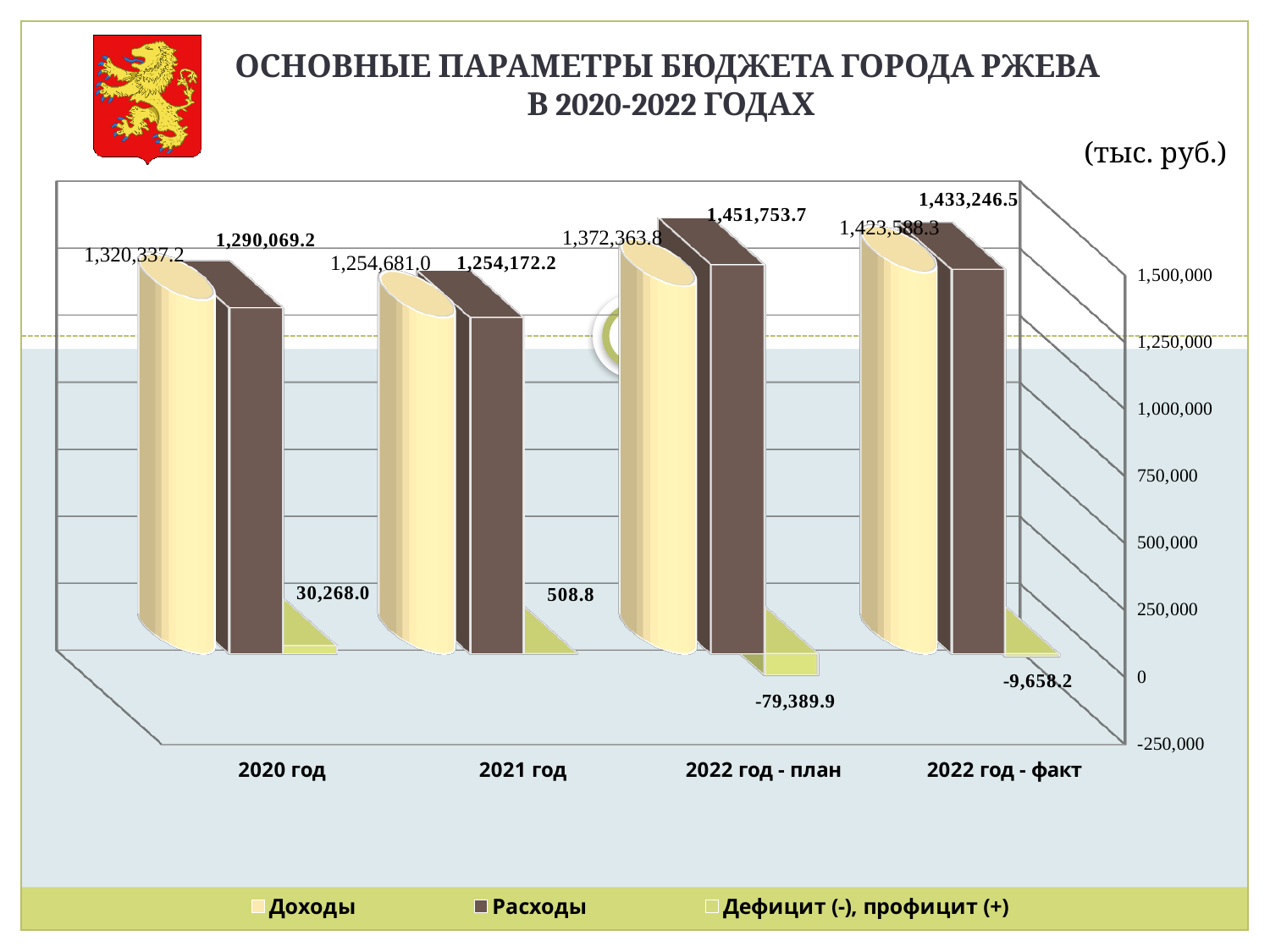
How many series does the legend list? 3 What is the value of Дефицит (-), профицит (+) for 2021 год? 508.8 Which category has the highest value of Расходы? 2022 год - план What unit is stated for the values on the chart? тыс. руб. What is the difference between Доходы and Расходы for 2020 год? 30,268.0 What is the value of Доходы for 2020 год? 1,320,337.2 Which category has the lowest value of Доходы? 2021 год Which is larger for 2022 год - факт: Доходы or Расходы? Расходы How many categories are shown on the x axis? 4 What is the value of Дефицит (-), профицит (+) for 2022 год - факт? -9,658.2 What is the value of Расходы for 2022 год - план? 1,451,753.7 What kind of chart is shown on the slide? Bar chart